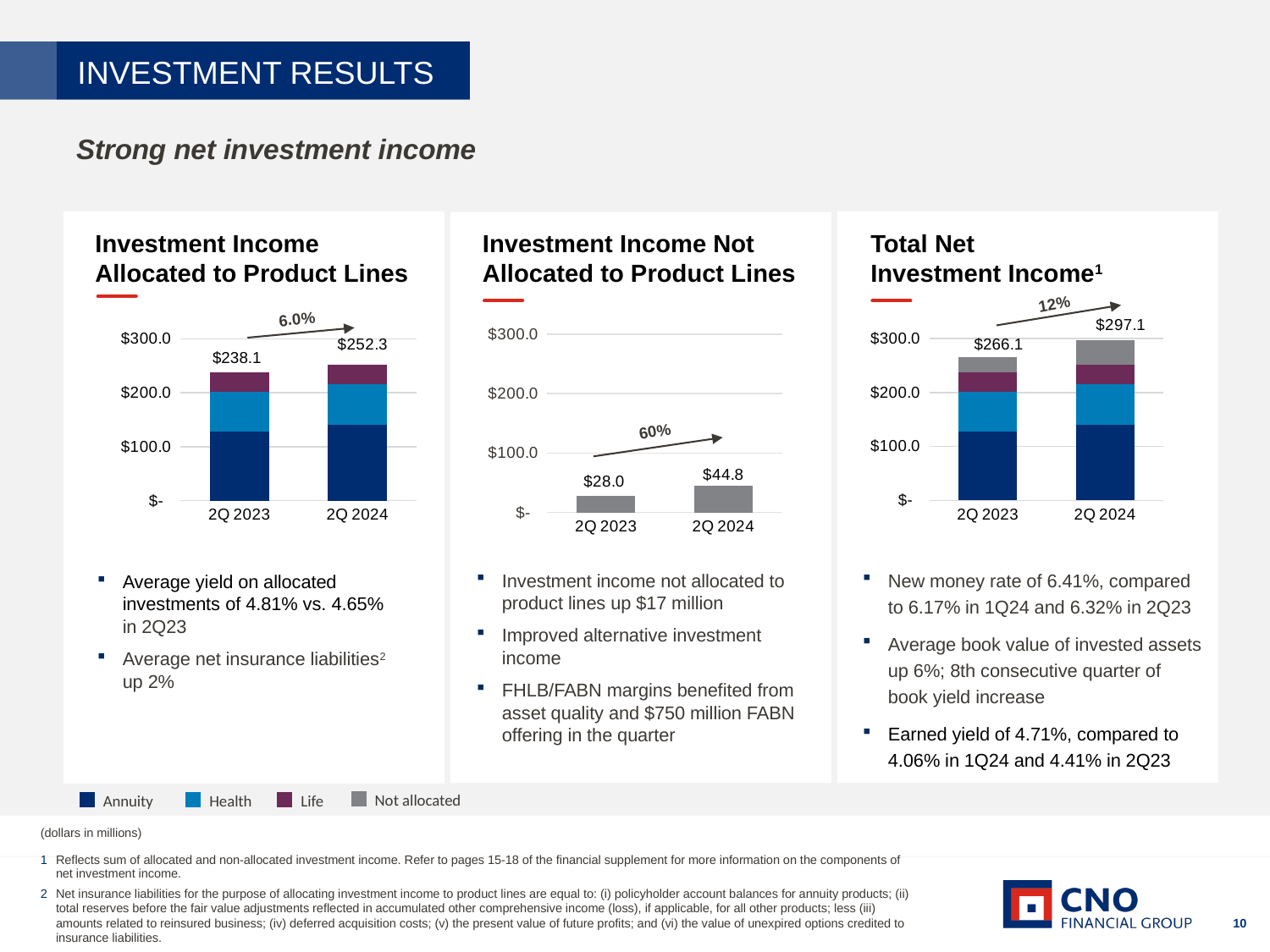
In the 'Investment Income Not Allocated to Product Lines' chart, is the value for 2Q 2024 greater or less than $100.0? less In the 'Total Net Investment Income' chart, what is the value for 2Q 2024? $297.1 In the 'Investment Income Allocated to Product Lines' chart, what is the total value for 2Q 2024? $252.3 In the 'Total Net Investment Income' chart, which quarter has the higher value? 2Q 2024 In the 'Investment Income Allocated to Product Lines' chart, what percentage growth is shown by the arrow? 6.0% What kind of chart is the 'Total Net Investment Income' chart? Stacked bar chart In the 'Investment Income Not Allocated to Product Lines' chart, what is the value for 2Q 2024? $44.8 In the 'Investment Income Not Allocated to Product Lines' chart, what is the value for 2Q 2023? $28.0 In the 'Investment Income Allocated to Product Lines' chart, what is the total value for 2Q 2023? $238.1 In the 'Total Net Investment Income' chart, what is the difference between the 2Q 2024 and 2Q 2023 values? $31.0 In the 'Investment Income Allocated to Product Lines' chart, what is the difference between the 2Q 2024 and 2Q 2023 totals? $14.2 In the 'Investment Income Not Allocated to Product Lines' chart, what is the difference between the 2Q 2024 and 2Q 2023 values? $16.8